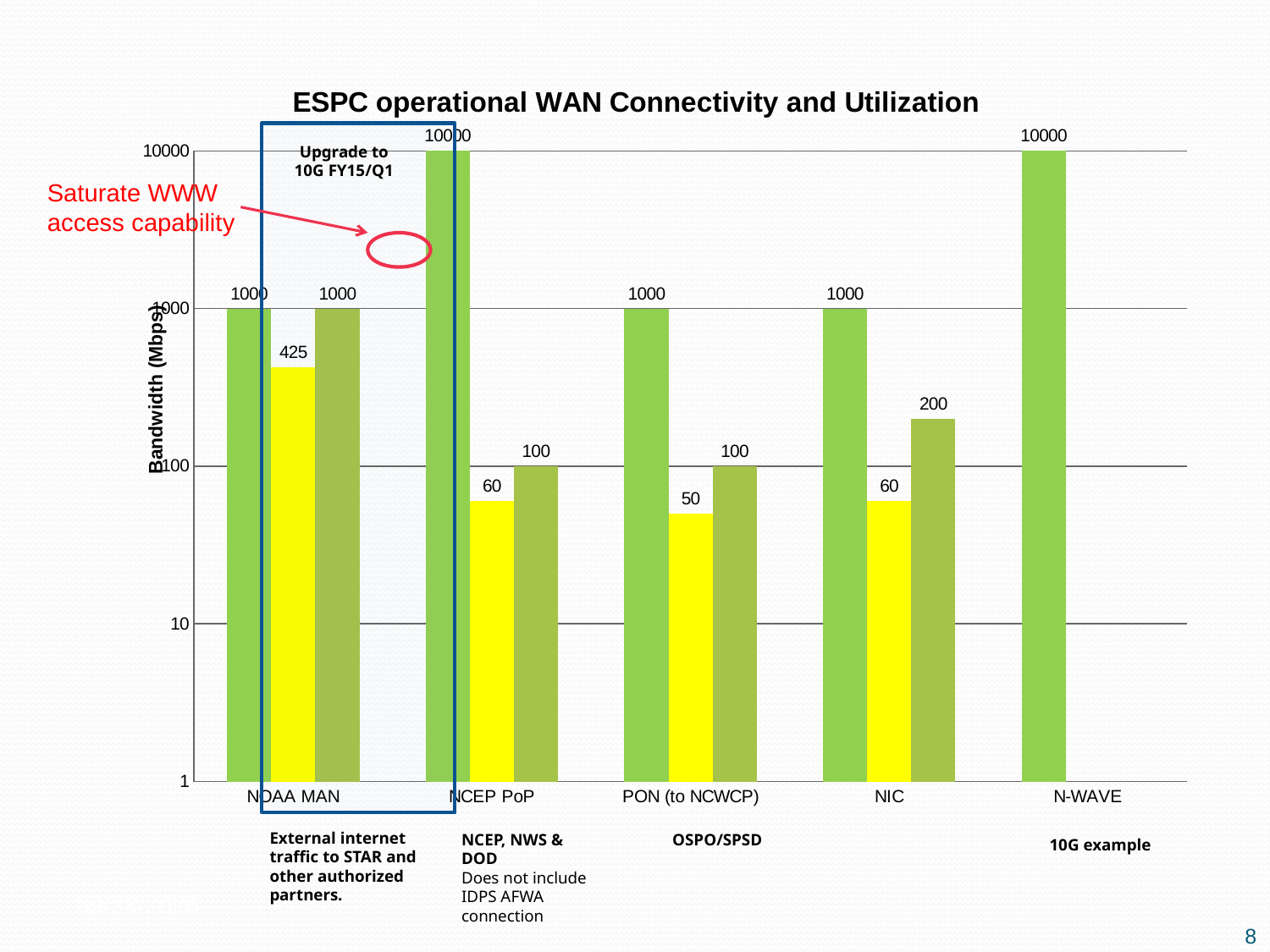
What is the title of the chart? ESPC operational WAN Connectivity and Utilization What is the difference between the green bar for NCEP PoP and the green bar for PON (to NCWCP)? 9000 What is the value of the yellow bar for NOAA MAN? 425 What is the value of the yellow bar for PON (to NCWCP)? 50 Which category has the lowest yellow bar? PON (to NCWCP) Which is larger, the yellow bar for NOAA MAN or the yellow bar for NIC? NOAA MAN What is the label of the y axis? Bandwidth (Mbps) What is the value of the olive bar for NIC? 200 How many categories are shown on the x axis of the chart? 5 What is the value of the bar for N-WAVE? 10000 What is the difference between the olive bar for NIC and the olive bar for NCEP PoP? 100 What type of chart is shown on the slide? bar chart